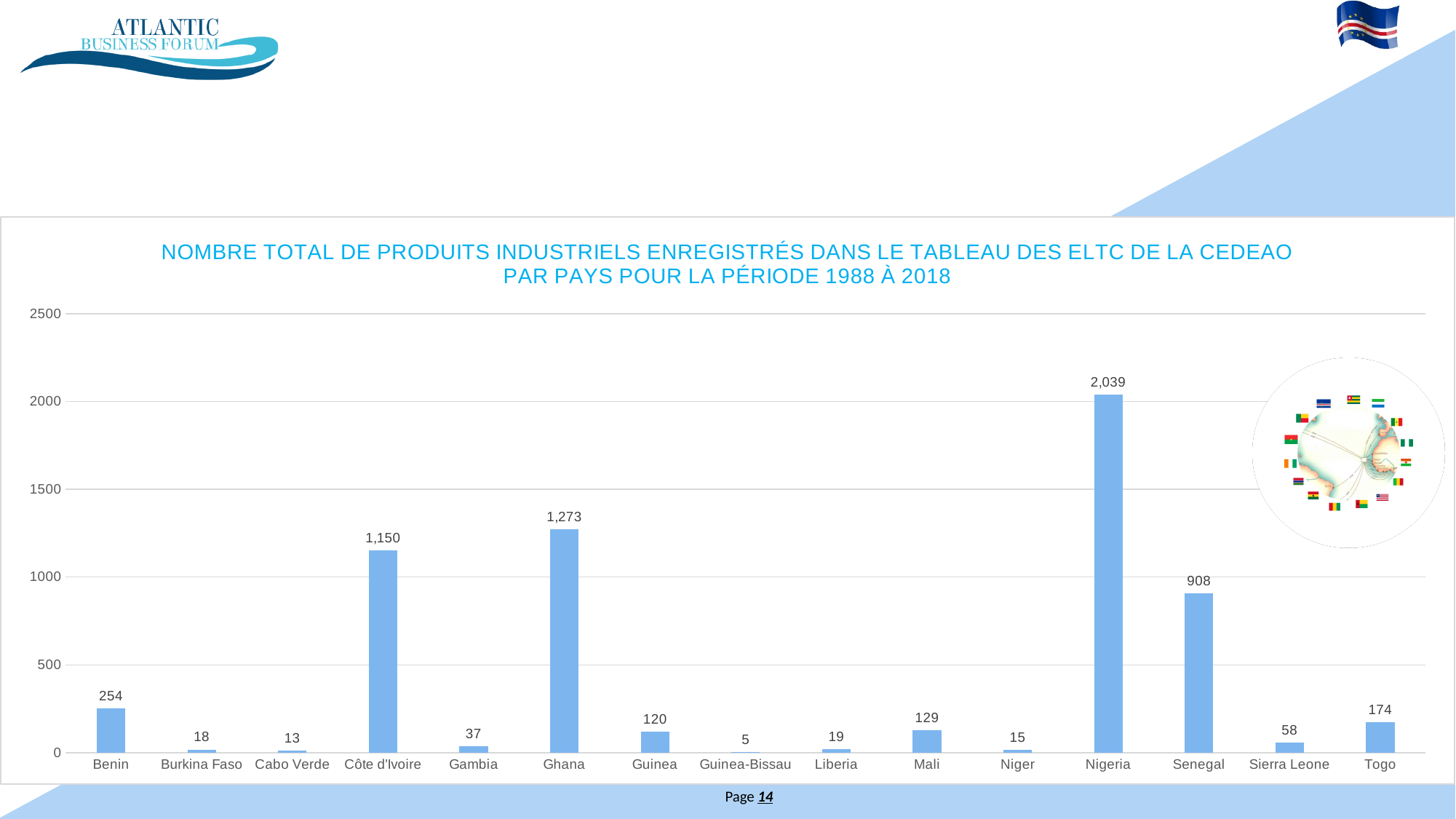
How many countries are shown on the x axis? 15 What is the value for Côte d'Ivoire? 1,150 What is the difference between the values for Ghana and Côte d'Ivoire? 123 Which country has the highest value? Nigeria Is the value for Senegal greater or less than 1000? less What period does the chart title say the data covers? 1988 à 2018 Which country has the lowest value? Guinea-Bissau What is the difference between the values for Nigeria and Senegal? 1,131 What kind of chart is shown on the slide? bar chart What is the value for Senegal? 908 Which is larger, the value for Benin or the value for Togo? Benin What is the value for Nigeria? 2,039